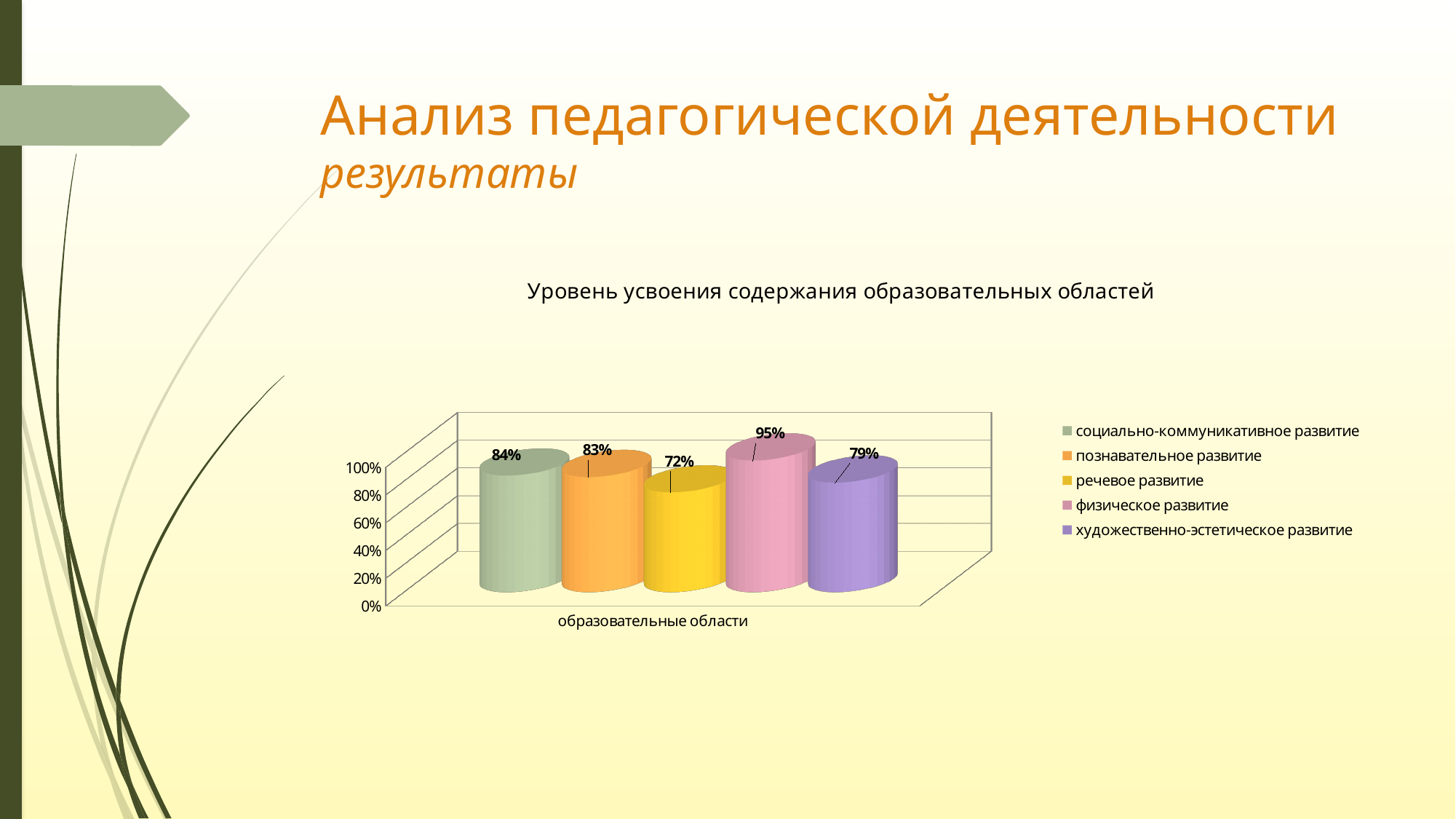
What is the value for речевое развитие? 72% Which series has the lowest value? речевое развитие What is the title of the chart? Уровень усвоения содержания образовательных областей Which series has the highest value? физическое развитие What is the difference between the values for физическое развитие and речевое развитие? 23% What is the value for познавательное развитие? 83% How many series does the legend list? 5 Which is larger, the value for социально-коммуникативное развитие or художественно-эстетическое развитие? социально-коммуникативное развитие What kind of chart is shown on the slide? bar chart What is the value for социально-коммуникативное развитие? 84% What is the value for художественно-эстетическое развитие? 79% What is the value for физическое развитие? 95%